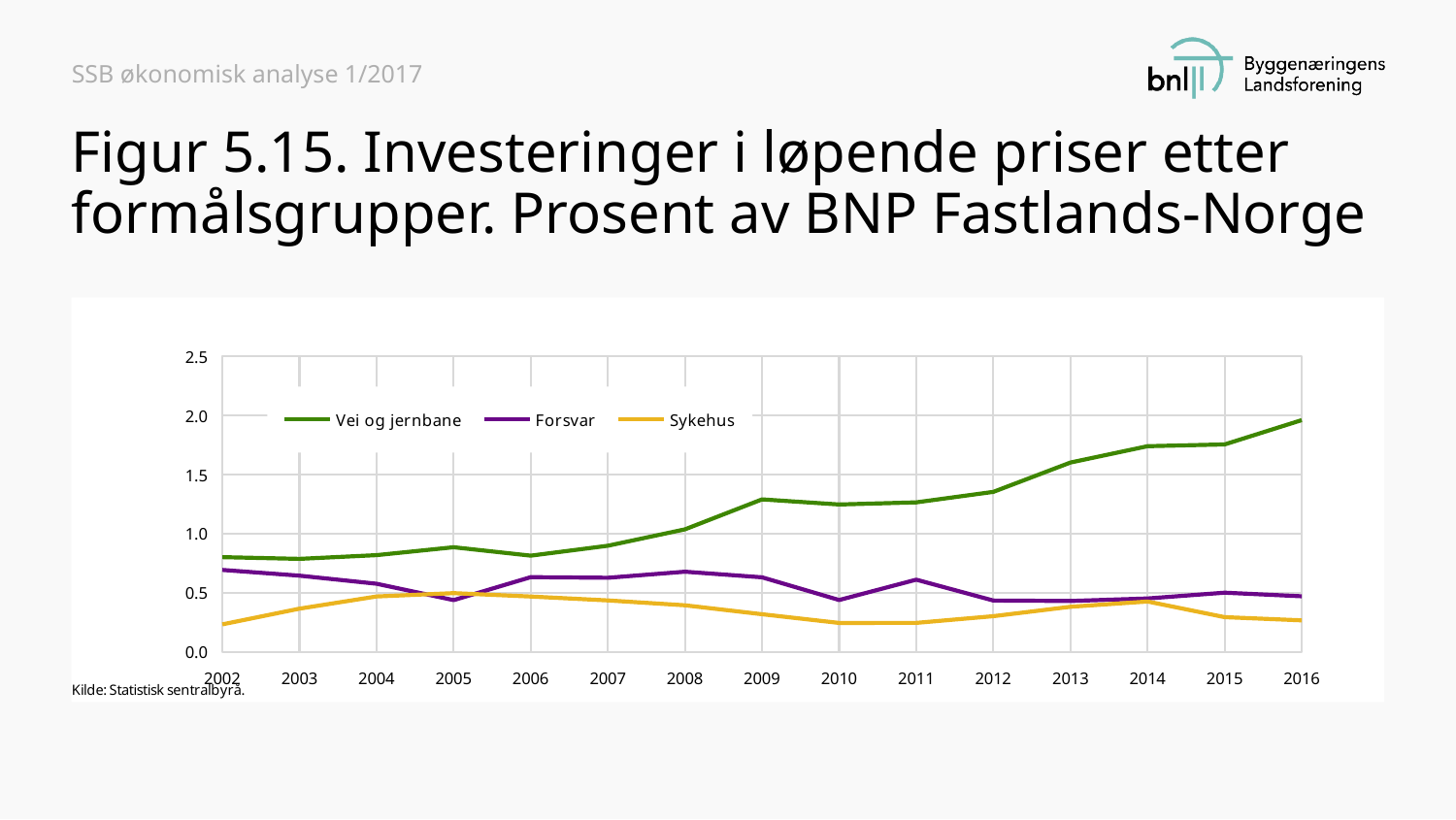
How many series does the legend list? 3 Is the value for Vei og jernbane in 2016 greater or less than 1.5? greater How many years are shown along the x axis? 15 Does the value for Vei og jernbane rise or fall overall from 2002 to 2016? Rise Is the value for Forsvar in 2002 greater or less than 0.5? greater Which series has the highest value in 2016? Vei og jernbane In 2016, which is higher, Forsvar or Sykehus? Forsvar What colour is the line for Vei og jernbane? Green Is the value for Vei og jernbane in 2002 greater or less than 1.0? less Which series has the lowest value in 2010? Sykehus What kind of chart is shown on the slide? Line chart